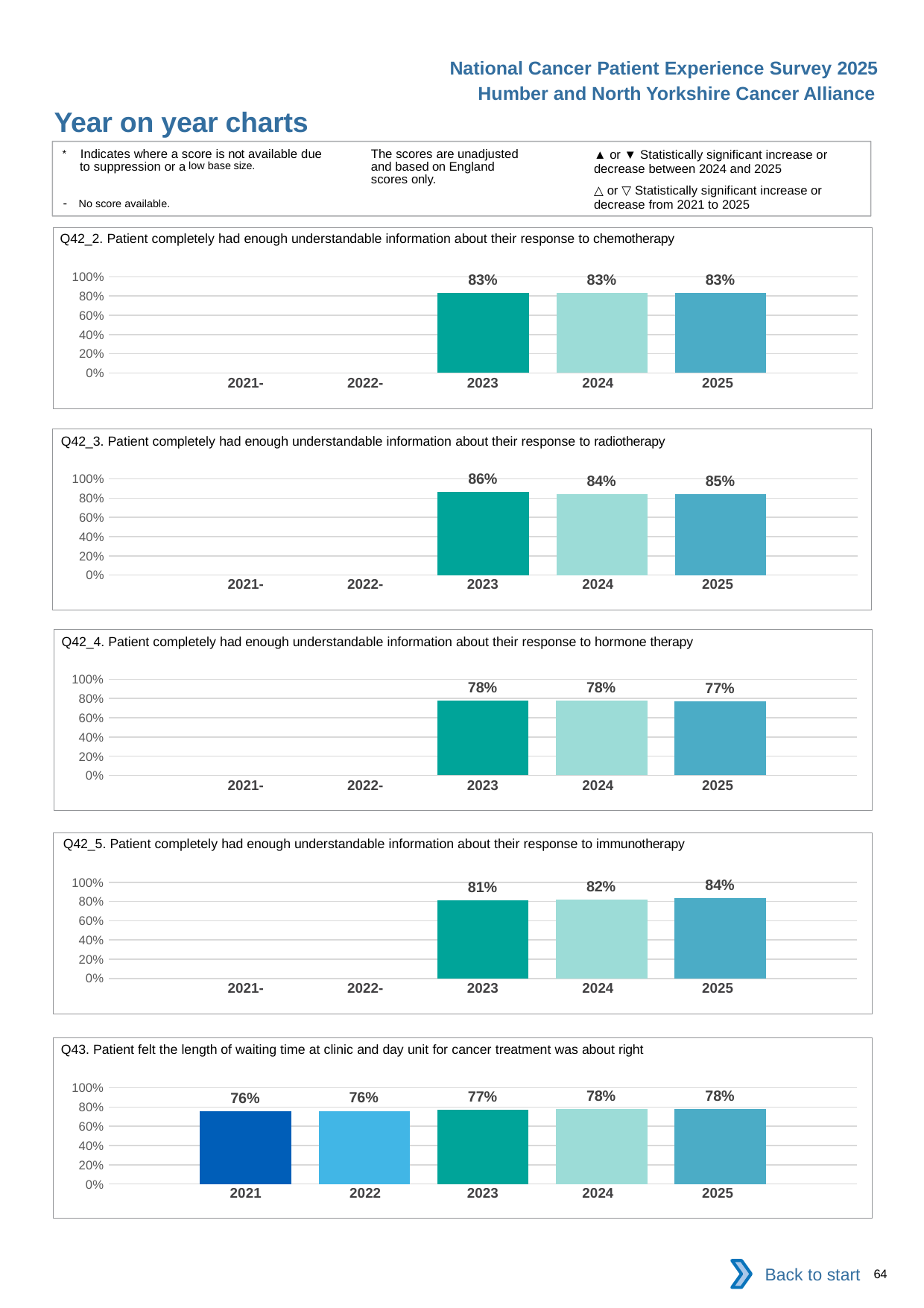
In the Q42_3 chart (radiotherapy), what is the difference between the 2023 and 2024 values? 2 percentage points In the Q43 chart (waiting time at clinic and day unit), what is the difference between the 2025 and 2021 values? 2 percentage points In the Q42_2 chart (chemotherapy), how many years have a bar plotted? 3 In the Q43 chart (waiting time at clinic and day unit), how many years have a bar plotted? 5 What type of chart is the Q43 chart? bar chart In the Q42_5 chart (immunotherapy), is the value for 2023 or 2025 larger? 2025 In the Q43 chart (waiting time at clinic and day unit), what is the value for 2021? 76% In the Q42_4 chart (hormone therapy), which year has the lowest value? 2025 In the Q42_2 chart (chemotherapy), what is the value for 2025? 83% In the Q42_3 chart (radiotherapy), which year has the highest value? 2023 In the Q42_4 chart (hormone therapy), what is the value for 2025? 77% In the Q42_5 chart (immunotherapy), do the values rise or fall from 2023 to 2025? rise